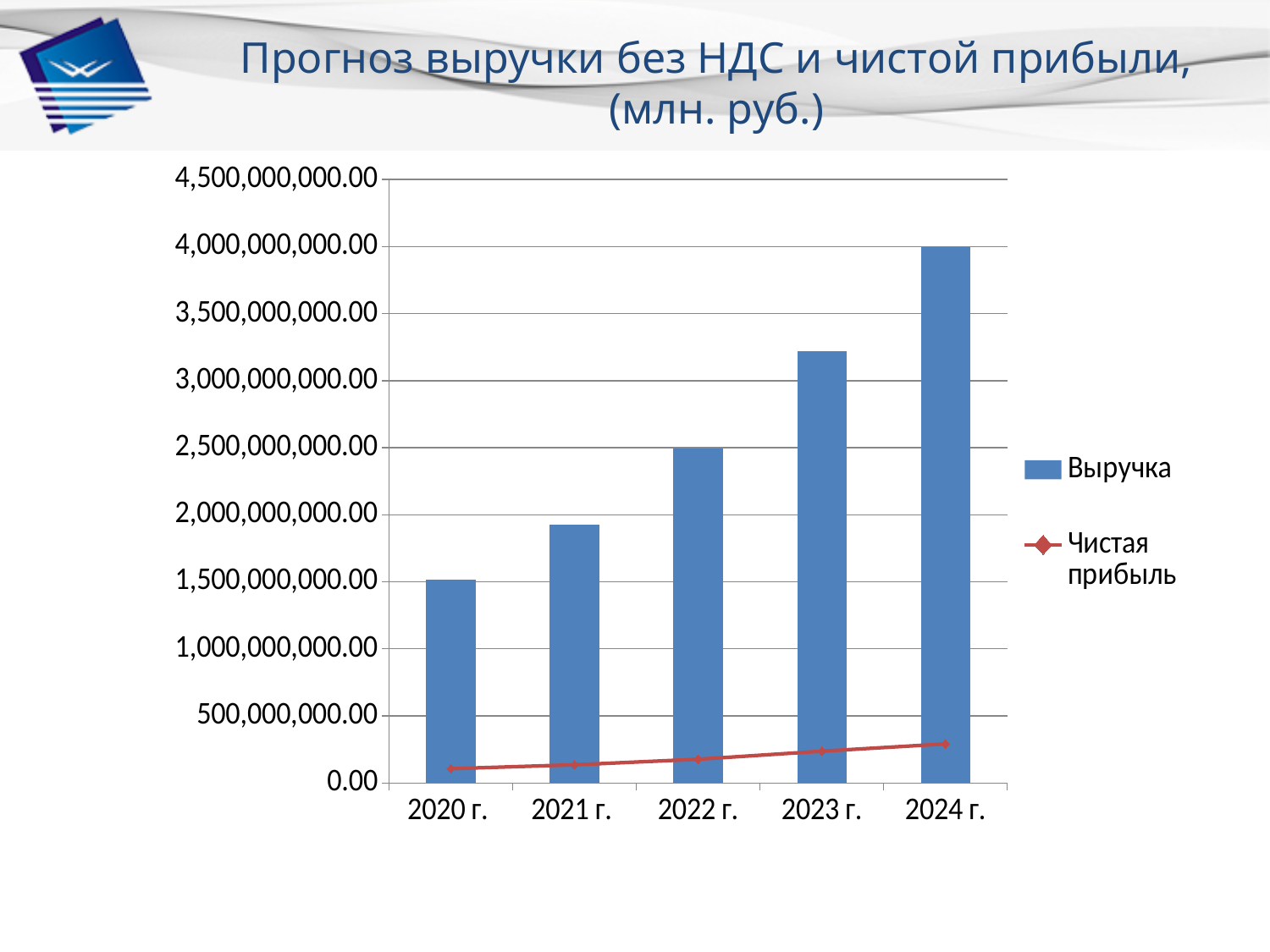
Which year has the highest Выручка bar? 2024 г. Is the Выручка value for 2020 г. greater or less than 2,000,000,000.00? less Which year has the larger Выручка value, 2022 г. or 2023 г.? 2023 г. Which year has the lowest Выручка bar? 2020 г. Is the Чистая прибыль value for 2024 г. greater or less than 500,000,000.00? less What kind of chart is shown on the slide? bar chart with a line series Is the Выручка value for 2023 г. greater or less than 3,000,000,000.00? greater How many years are shown on the x axis? 5 How many series does the legend list? 2 Which series is drawn as a line with markers? Чистая прибыль Do the Выручка values rise or fall from 2020 г. to 2024 г.? rise